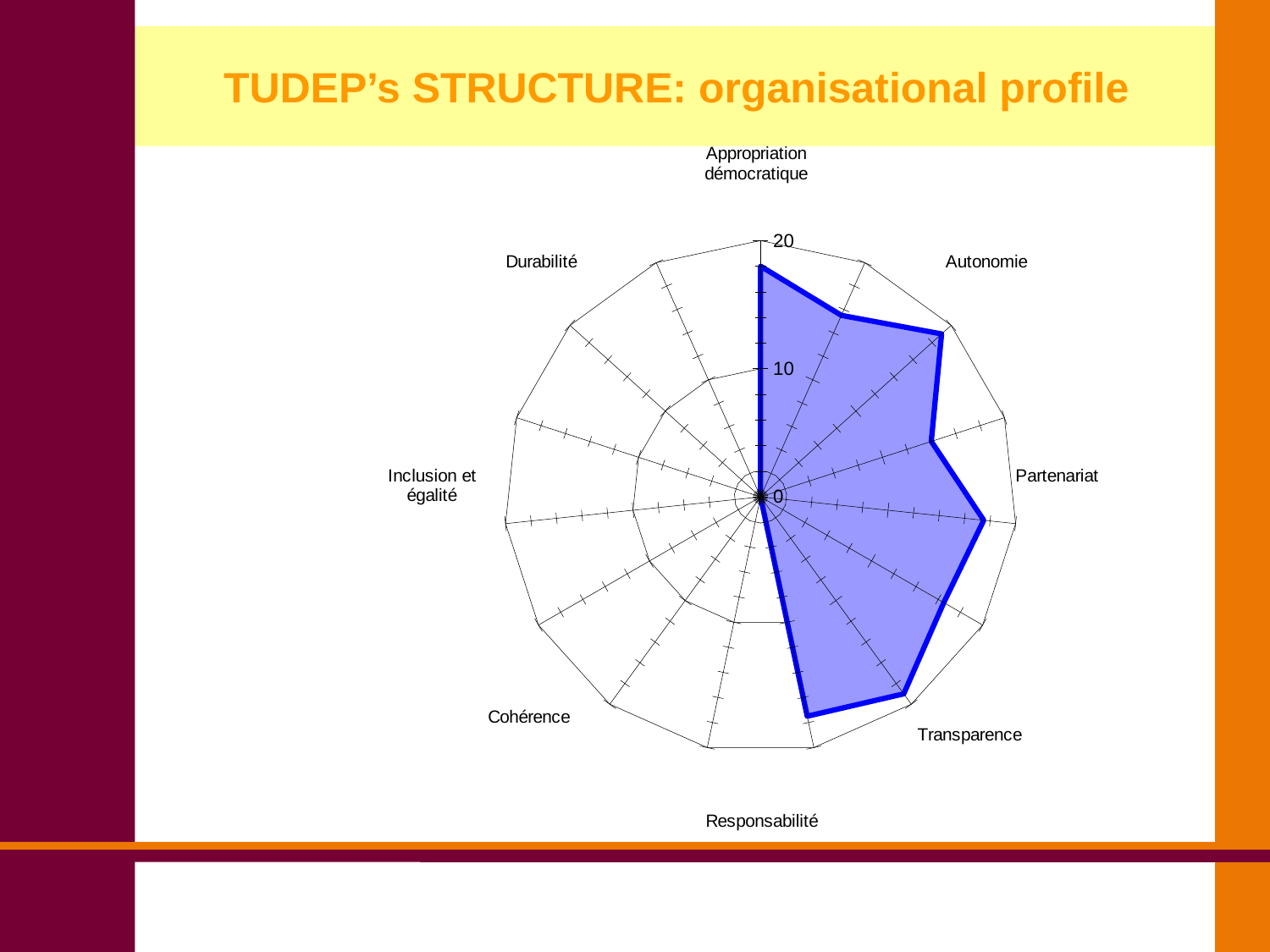
Is the value for Inclusion et égalité greater or less than 10? less Is the value for Durabilité greater or less than 10? less How many category labels are shown around the radar chart? 8 What is the highest value marked on the chart's radial axis? 20 Is the value for Transparence greater or less than 10? greater Which has the larger value, Partenariat or Cohérence? Partenariat What kind of chart is shown on the slide? radar chart Which has the larger value, Durabilité or Autonomie? Autonomie What is the title of the slide containing the chart? TUDEP's STRUCTURE: organisational profile